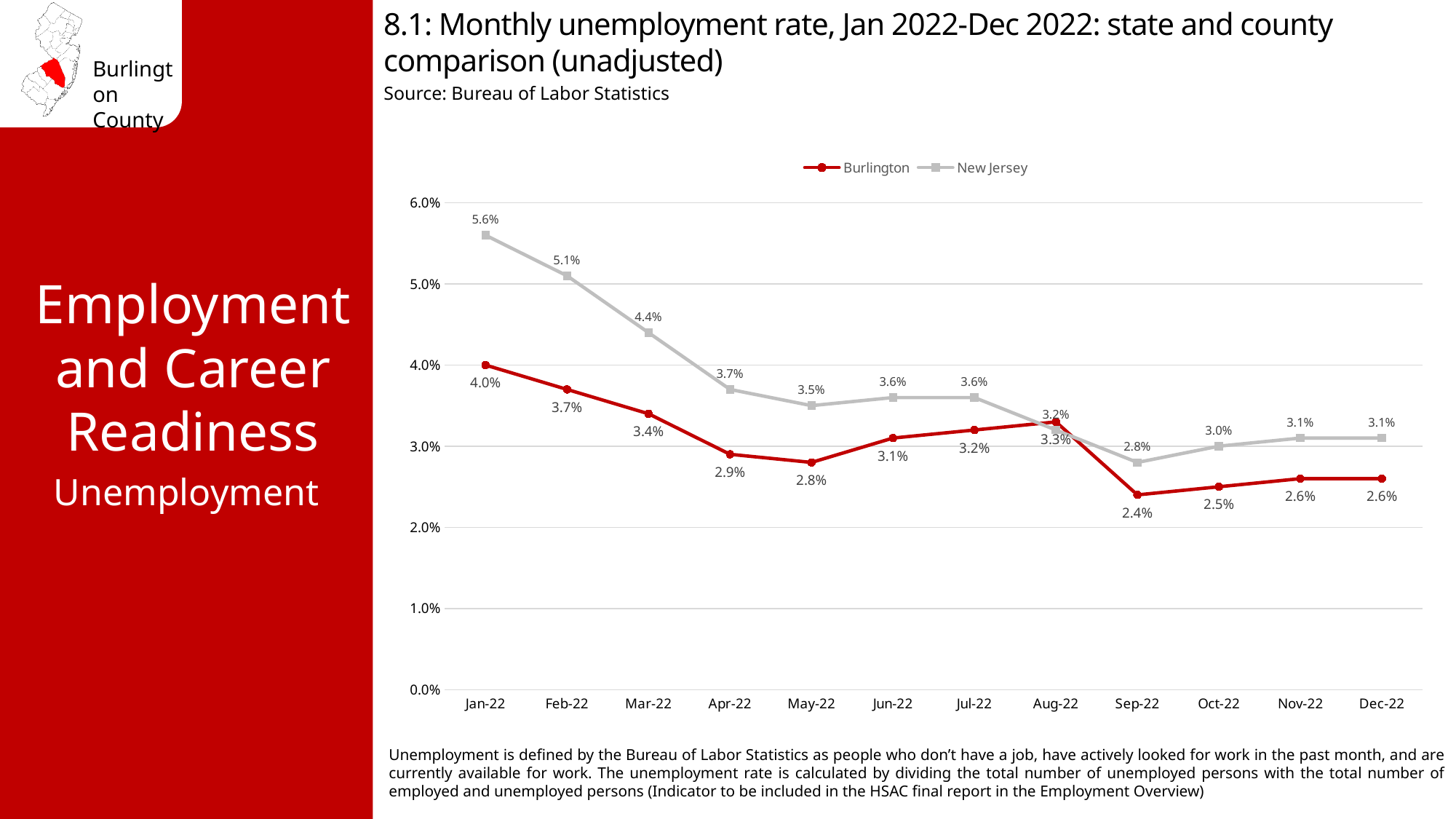
How many series does the legend list? 2 What is the source cited for the chart? Bureau of Labor Statistics What was Burlington's unemployment rate in Sep-22? 2.4% What was Burlington's unemployment rate in Jan-22? 4.0% How many months are plotted on the x axis? 12 Did New Jersey's unemployment rate rise or fall from Jan-22 to Apr-22? Fall In which month was New Jersey's unemployment rate highest? Jan-22 What kind of chart is shown? Line chart In Aug-22, which had the higher unemployment rate, Burlington or New Jersey? Burlington What was New Jersey's unemployment rate in Mar-22? 4.4% In which month was Burlington's unemployment rate lowest? Sep-22 What is the difference between New Jersey's and Burlington's unemployment rates in Jan-22? 1.6%